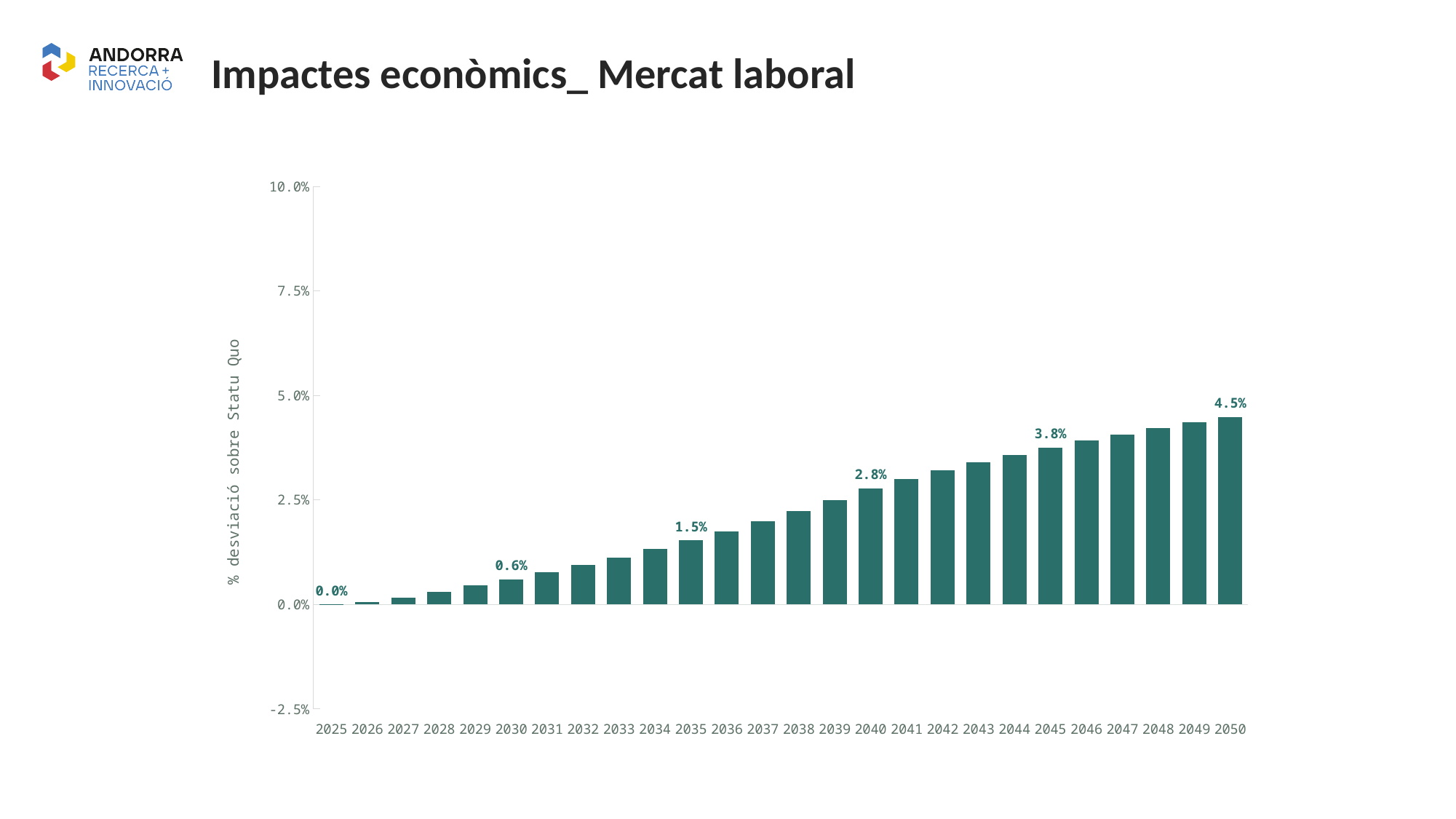
How many years are shown on the x axis? 26 Do the values rise or fall from 2025 to 2050? rise What is the value for 2040? 2.8% Which year has the lowest value? 2025 What is the value for 2045? 3.8% Is the value for 2038 greater or less than 2.5%? less What is the value for 2035? 1.5% What is the value for 2030? 0.6% Which is larger, the value for 2035 or the value for 2045? 2045 What is the difference between the values for 2050 and 2040? 1.7% Which year has the highest value? 2050 What is the value for 2050? 4.5%